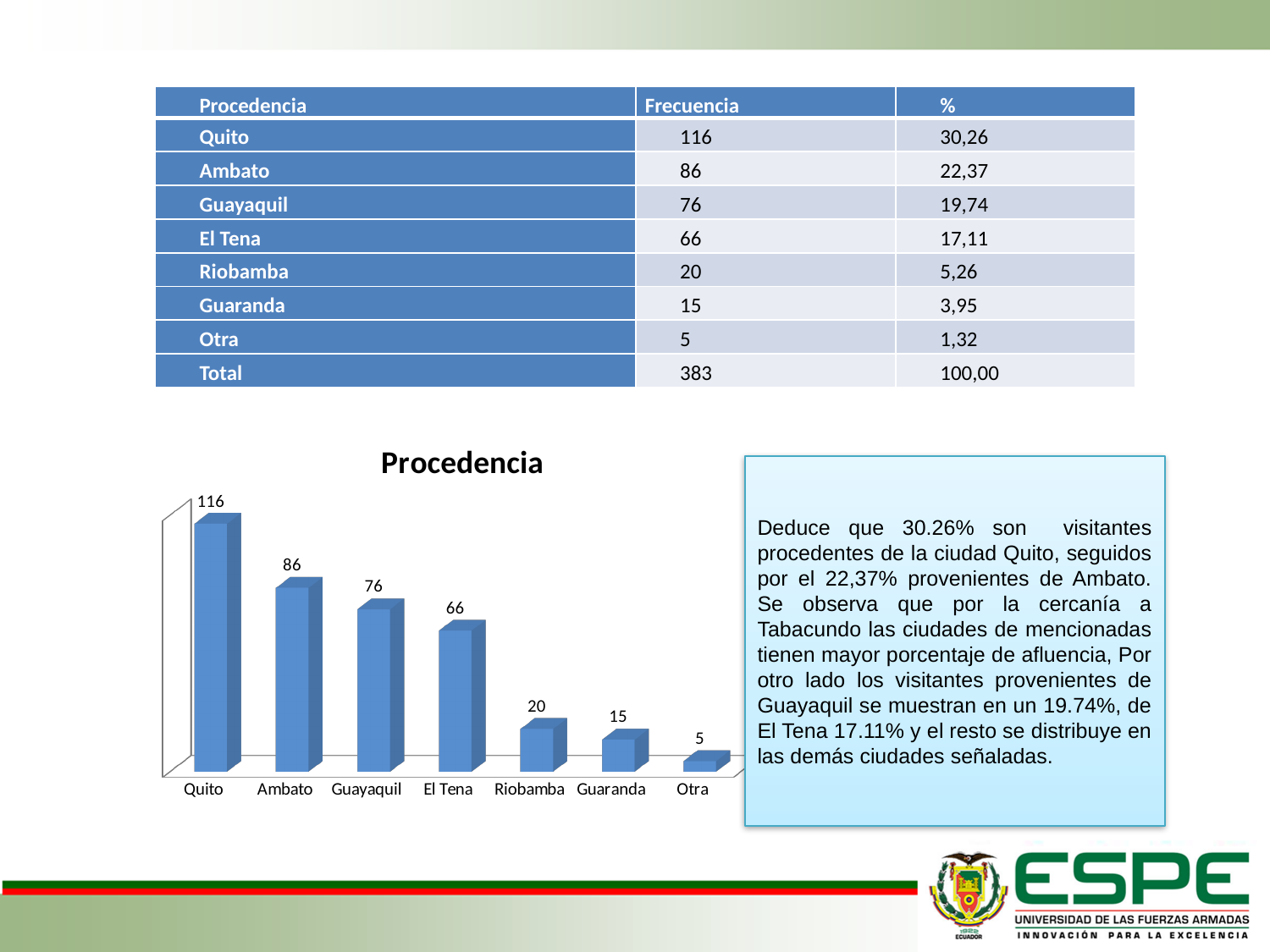
What is the value for Guaranda in the Procedencia chart? 15 What is the difference between the values for Guayaquil and Riobamba in the Procedencia chart? 56 Which category has the lowest value in the Procedencia chart? Otra What kind of chart is the Procedencia chart? bar chart Do the values in the Procedencia chart rise or fall from left to right along the x axis? fall What is the value for Quito in the Procedencia chart? 116 How many categories are shown in the Procedencia chart? 7 What is the difference between the values for Quito and Ambato in the Procedencia chart? 30 What is the title of the chart on the slide? Procedencia Which is larger in the Procedencia chart, the value for Ambato or the value for Guayaquil? Ambato What is the value for El Tena in the Procedencia chart? 66 Which category has the highest value in the Procedencia chart? Quito